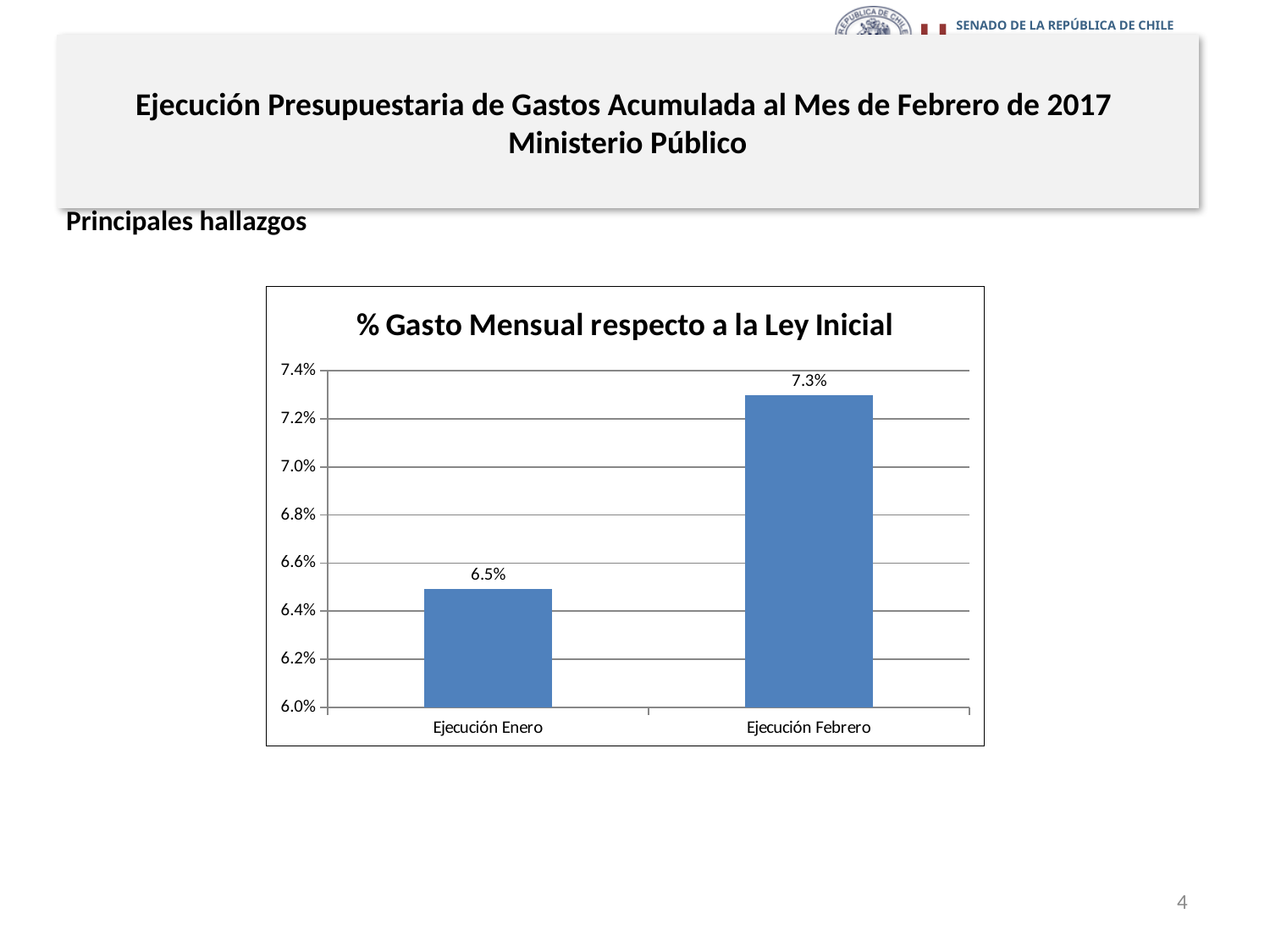
How many categories are shown in the chart? 2 Is the value for Ejecución Febrero greater or less than 7.0%? greater What is the title of the chart? % Gasto Mensual respecto a la Ley Inicial Which category has the highest value? Ejecución Febrero Which category has the lowest value? Ejecución Enero Do the values rise or fall from Ejecución Enero to Ejecución Febrero? Rise What is the difference between the values for Ejecución Febrero and Ejecución Enero? 0.8% Is the value for Ejecución Enero greater or less than 6.8%? less Which is larger, the value for Ejecución Enero or Ejecución Febrero? Ejecución Febrero What is the value for Ejecución Enero? 6.5% What kind of chart is shown on the slide? Bar chart What is the value for Ejecución Febrero? 7.3%